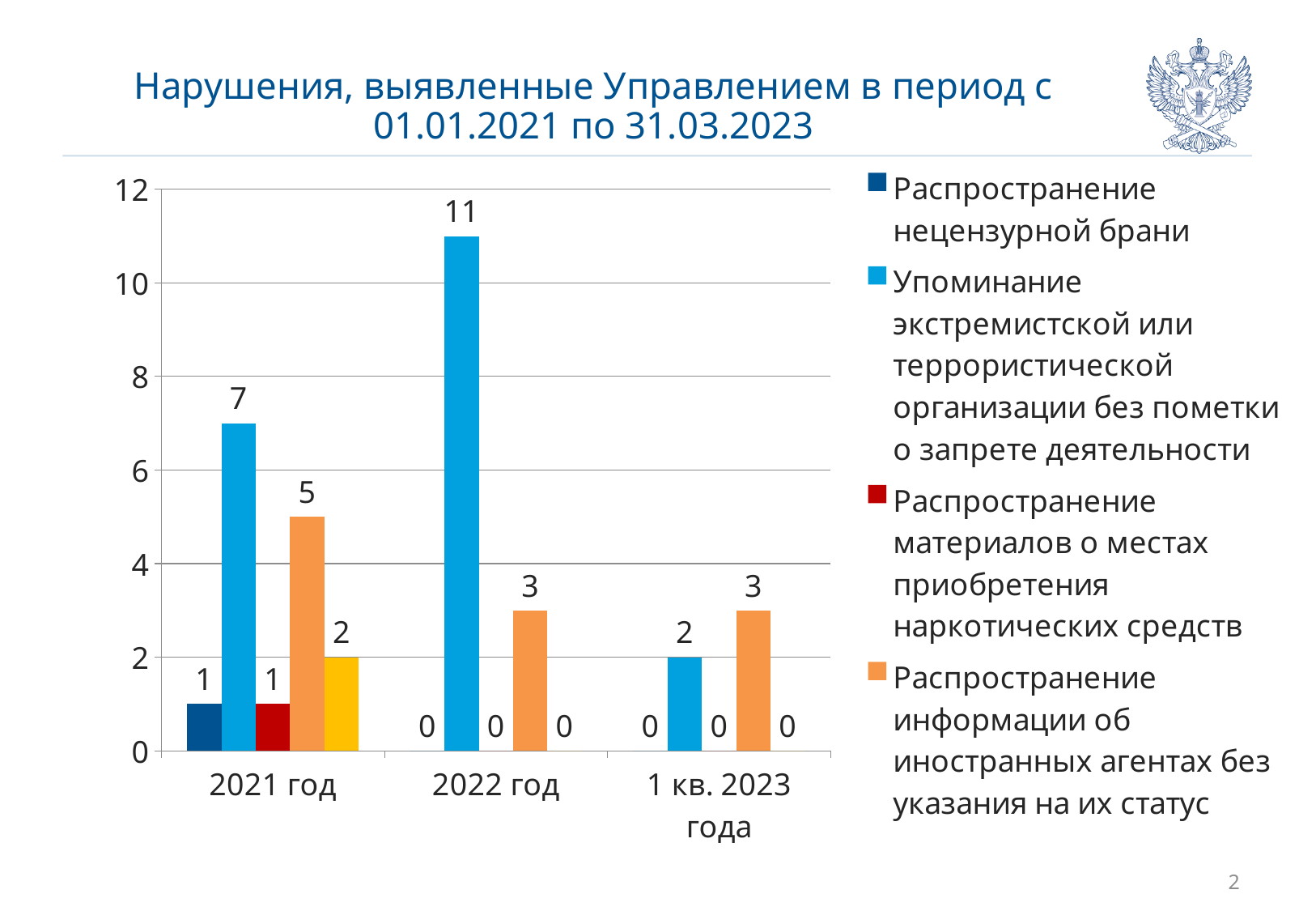
What type of chart is shown on the slide? bar chart What is the value for 'Распространение нецензурной брани' in 2021 год? 1 What is the title of the chart slide? Нарушения, выявленные Управлением в период с 01.01.2021 по 31.03.2023 How many categories are shown on the x axis? 3 What is the value for 'Упоминание экстремистской или террористической организации без пометки о запрете деятельности' in 2022 год? 11 How many series does the legend list? 4 In which category does 'Упоминание экстремистской или террористической организации без пометки о запрете деятельности' reach its highest value? 2022 год Which is larger in 1 кв. 2023 года: 'Упоминание экстремистской или террористической организации без пометки о запрете деятельности' or 'Распространение информации об иностранных агентах без указания на их статус'? Распространение информации об иностранных агентах без указания на их статус What is the value for 'Распространение информации об иностранных агентах без указания на их статус' in 2021 год? 5 What is the value for 'Распространение материалов о местах приобретения наркотических средств' in 2022 год? 0 What is the difference between the 'Упоминание экстремистской или террористической организации без пометки о запрете деятельности' values for 2022 год and 2021 год? 4 In which category does 'Упоминание экстремистской или террористической организации без пометки о запрете деятельности' have its lowest value? 1 кв. 2023 года